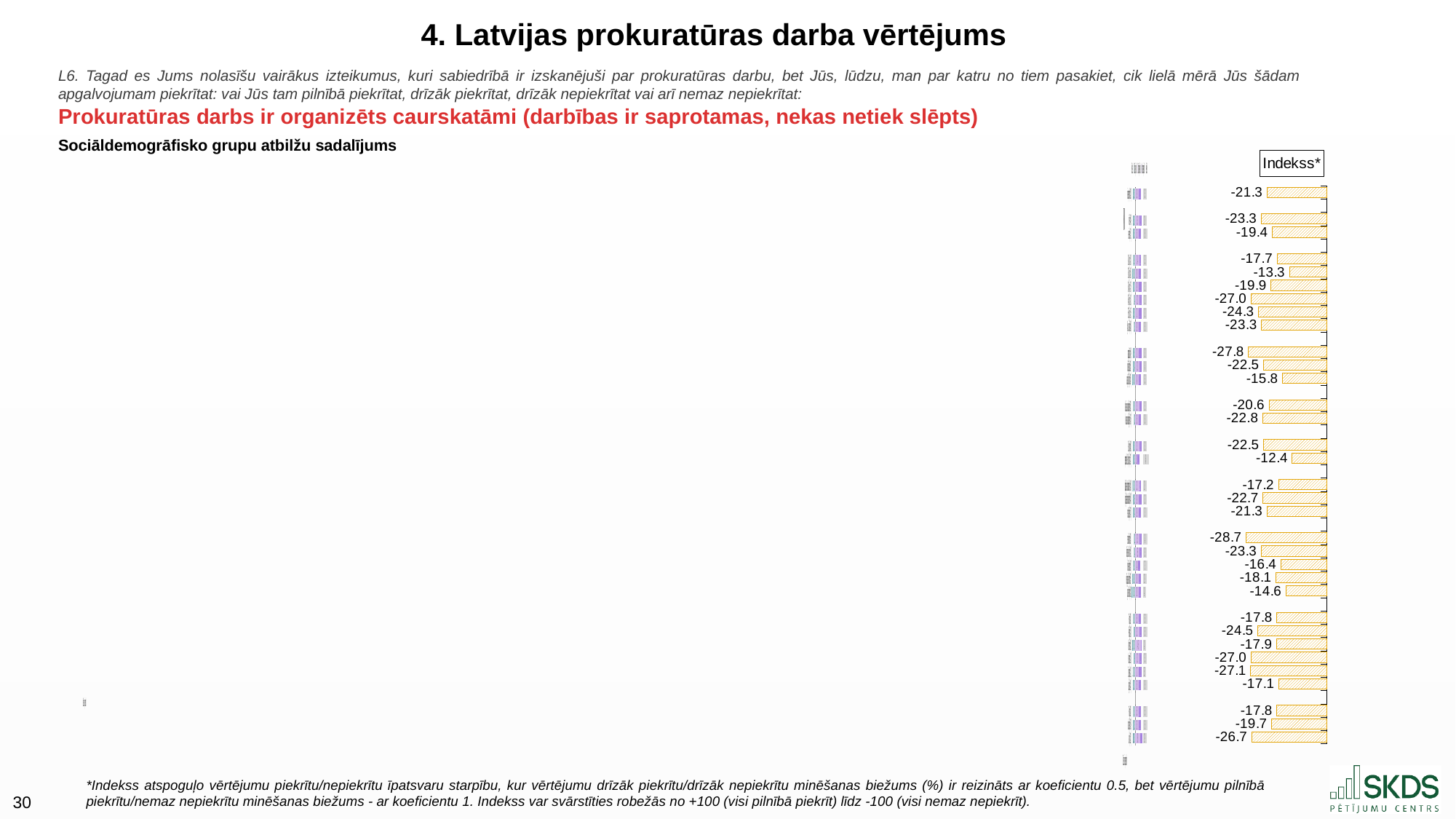
In the Indekss* chart, is the value of the topmost bar greater or less than -20? less In the Indekss* chart, what is the lowest (most negative) value shown? -28.7 In the Indekss* chart, what is the difference between the topmost bar (-21.3) and the bottom bar (-26.7)? 5.4 How many bars are plotted in the Indekss* chart? 33 In the Indekss* chart, what is the value of the bottom bar? -26.7 In the Indekss* chart, what is the highest (least negative) value shown? -12.4 In the Indekss* chart, what is the value of the topmost bar? -21.3 What is the title shown above the chart on the right of the slide? Indekss* In the Indekss* chart, which is larger: the topmost bar's value (-21.3) or the bottom bar's value (-26.7)? -21.3 In the Indekss* chart, are all the plotted index values greater or less than 0? less In the Indekss* chart, what is the difference between the highest value (-12.4) and the lowest value (-28.7)? 16.3 What kind of chart is the Indekss* chart on the right of the slide? bar chart